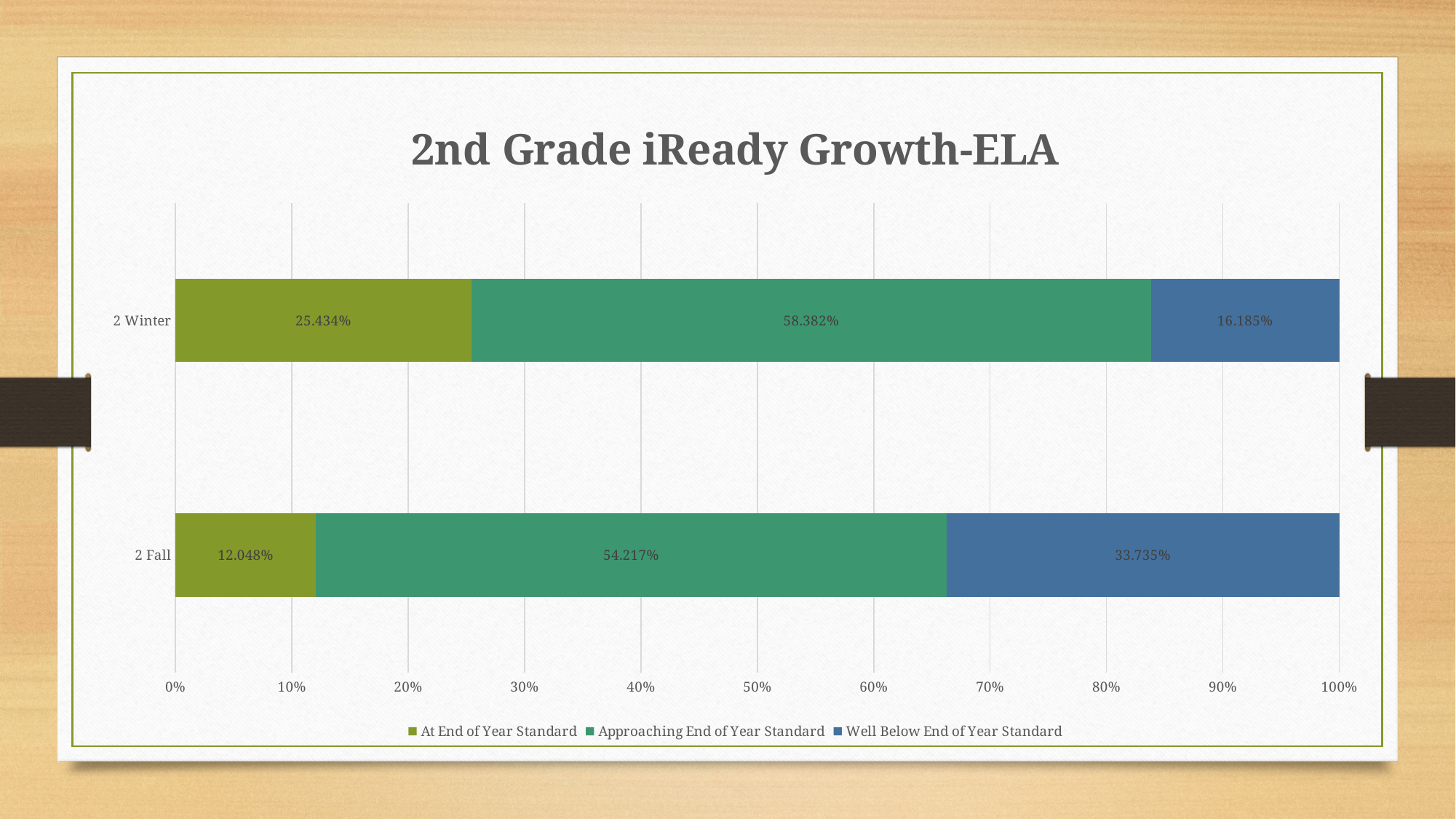
What is the value for At End of Year Standard in 2 Winter? 25.434% What is the difference between the Well Below End of Year Standard values for 2 Fall and 2 Winter? 17.550% What is the difference between the At End of Year Standard values for 2 Winter and 2 Fall? 13.386% What is the value for Well Below End of Year Standard in 2 Fall? 33.735% What kind of chart is shown on the slide? Stacked bar chart Which series has the smallest value in 2 Winter? Well Below End of Year Standard How many categories are shown on the chart? 2 Which category has the higher value for Well Below End of Year Standard, 2 Winter or 2 Fall? 2 Fall What is the value for Approaching End of Year Standard in 2 Winter? 58.382% What is the value for At End of Year Standard in 2 Fall? 12.048% How many series does the legend list? 3 Which series has the largest value in 2 Fall? Approaching End of Year Standard